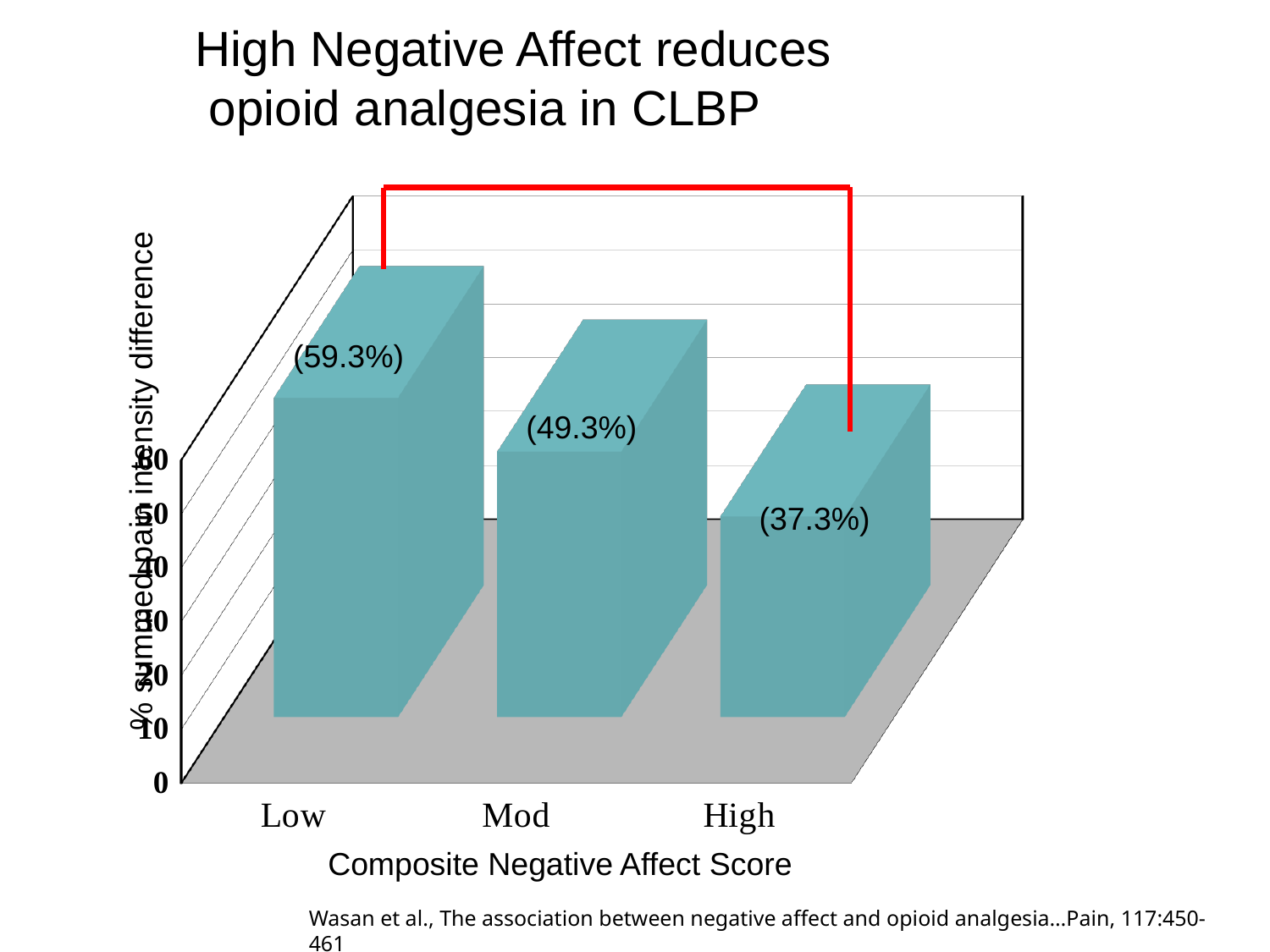
Which Composite Negative Affect Score category has the lowest value? High What is the value for the Mod category? 49.3% How many categories are shown on the x axis? 3 What kind of chart is shown on the slide? Bar chart Is the value for High greater or less than 40? less What is the difference between the values for Low and Mod? 10 percentage points What is the value for the Low category? 59.3% Do the values rise or fall from Low to High along the x axis? Fall What is the difference between the values for Low and High? 22 percentage points Which Composite Negative Affect Score category has the highest value? Low What is the value for the High category? 37.3% Which is larger, the value for Mod or the value for High? Mod